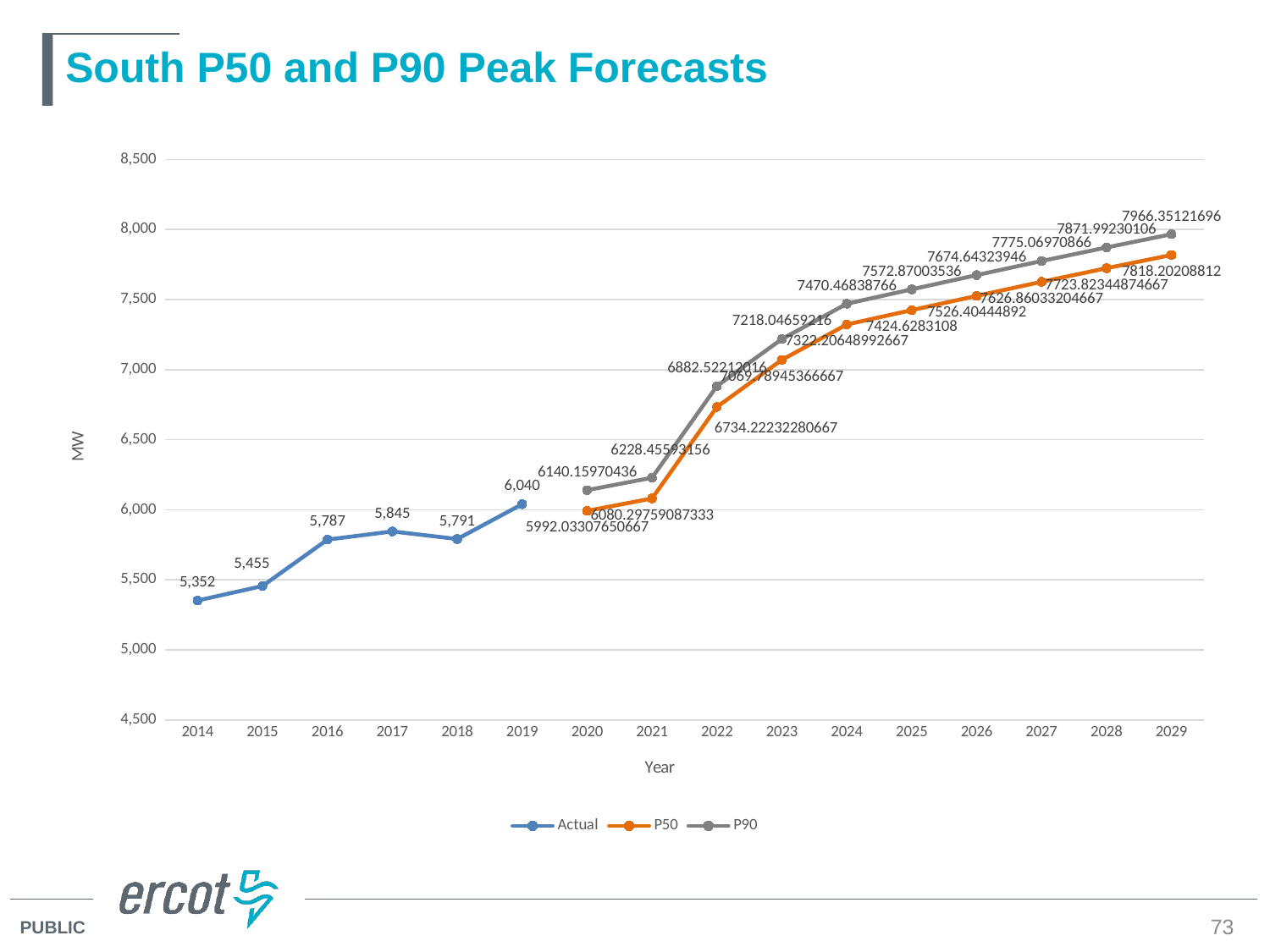
Does the P90 series rise or fall from 2020 to 2029? rise Which year has the larger Actual value, 2017 or 2018? 2017 What type of chart is shown on the slide? line chart What is the P50 value for 2029? 7818.20208812 What is the difference between the Actual values for 2019 and 2014? 688 In which year is the Actual series lowest? 2014 In which year is the Actual series highest? 2019 Is the P90 value for 2024 greater or less than 7,000? greater What is the P90 value for 2029? 7966.35121696 How many series does the legend list? 3 What is the Actual value for 2014? 5,352 What is the Actual value for 2019? 6,040